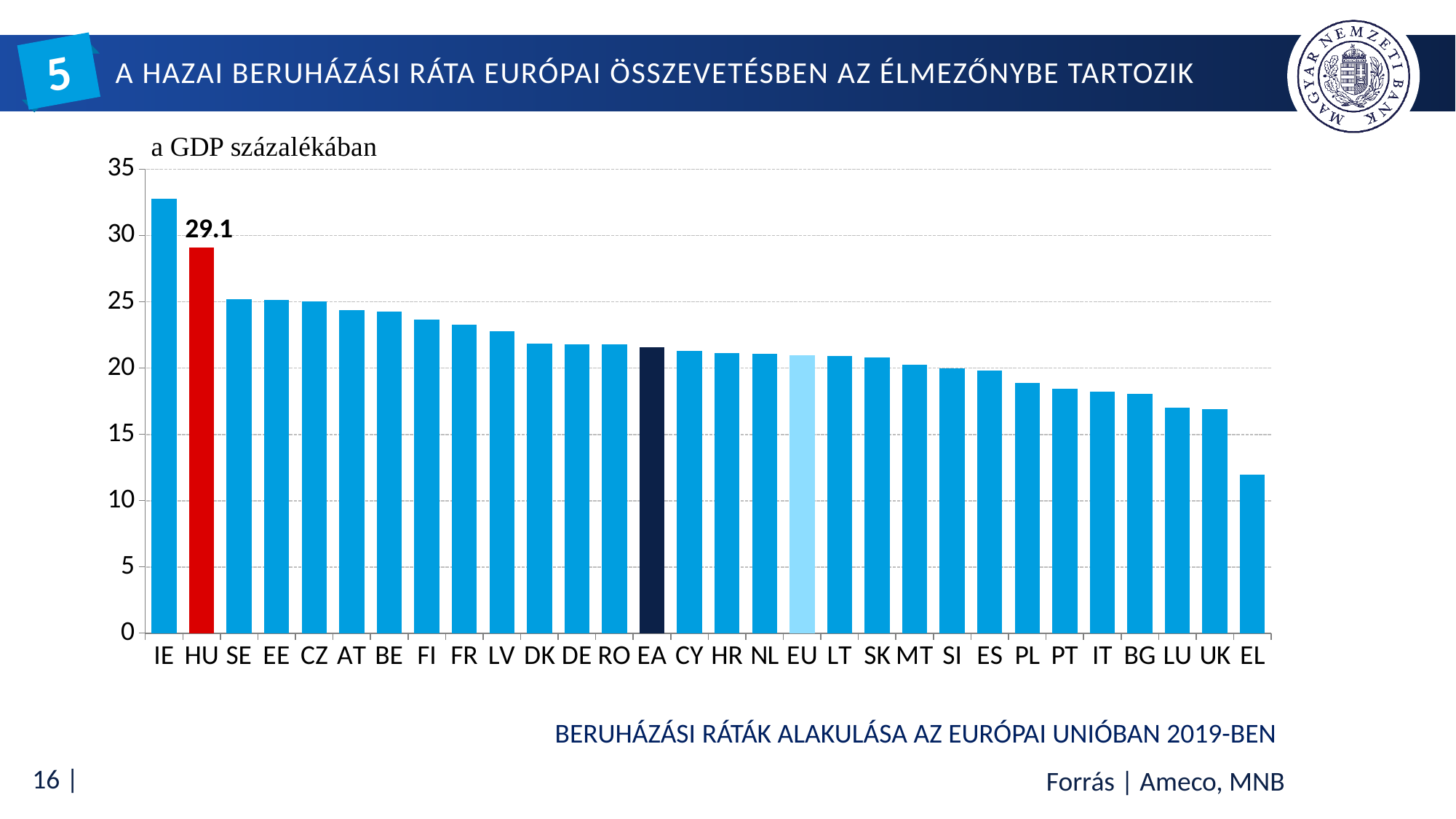
What value is labelled on the bar for HU? 29.1 Which has a larger value, EL or UK? UK How many bars (countries or aggregates) are shown in the chart? 30 Is the value for HU greater or less than 30? less Which country has the highest investment rate in the chart? IE What kind of chart is shown on the slide? Bar chart Which has a larger value, IE or HU? IE Do the values rise or fall from left to right along the x axis? Fall Is the value for IE greater or less than 30? greater Which country has the lowest investment rate in the chart? EL Is the value for EL greater or less than 15? less